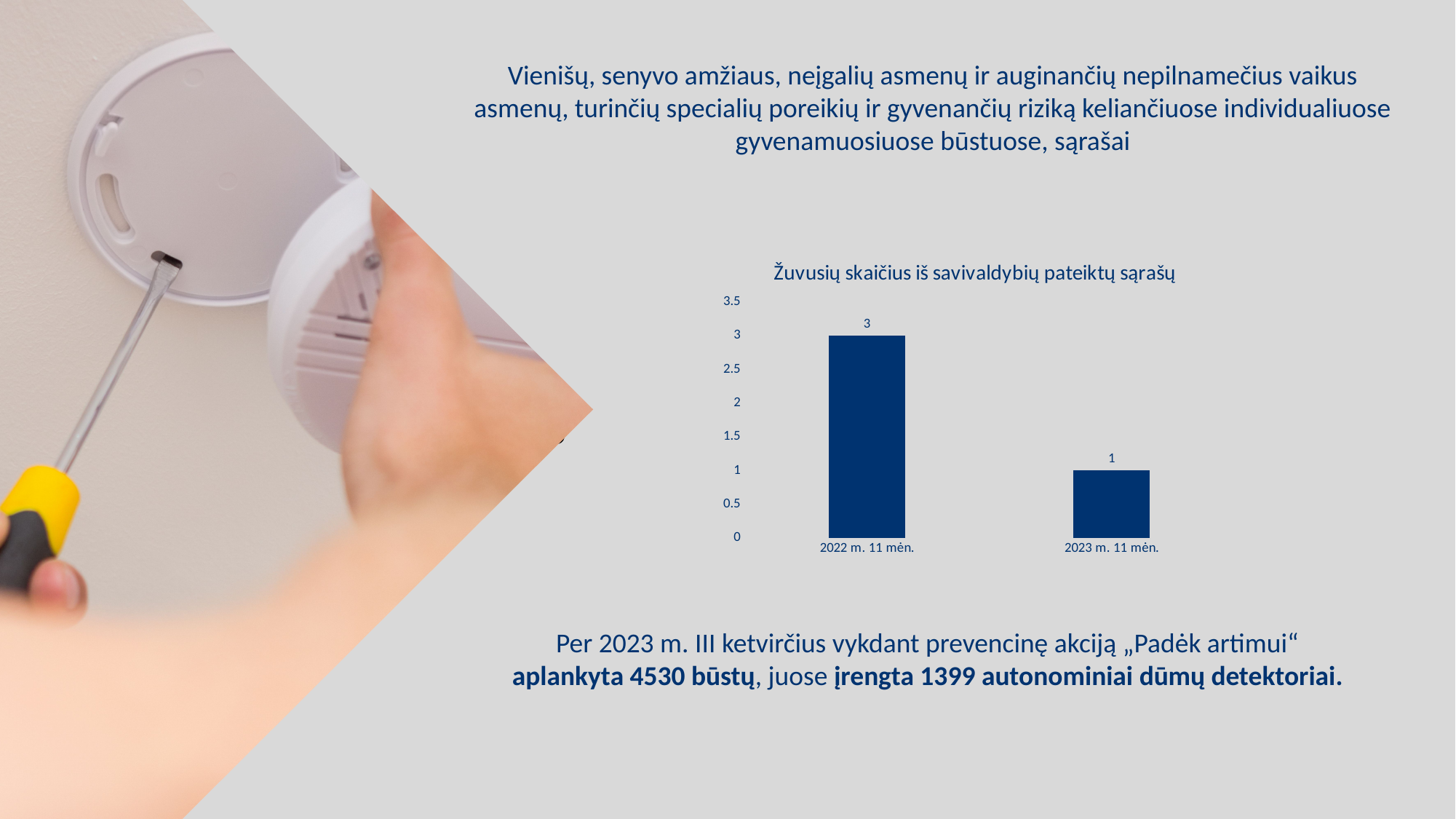
Do the values rise or fall from 2022 m. 11 mėn. to 2023 m. 11 mėn.? fall How many categories are shown on the x axis? 2 What is the maximum value shown on the y axis? 3.5 What is the value for 2022 m. 11 mėn.? 3 Which category has the lowest value? 2023 m. 11 mėn. What kind of chart is shown on the slide? bar chart What is the title of the chart? Žuvusių skaičius iš savivaldybių pateiktų sąrašų What is the difference between the values for 2022 m. 11 mėn. and 2023 m. 11 mėn.? 2 What is the value for 2023 m. 11 mėn.? 1 Is the value for 2022 m. 11 mėn. greater or less than 2? greater Which is larger, the value for 2022 m. 11 mėn. or for 2023 m. 11 mėn.? 2022 m. 11 mėn. Which category has the highest value? 2022 m. 11 mėn.